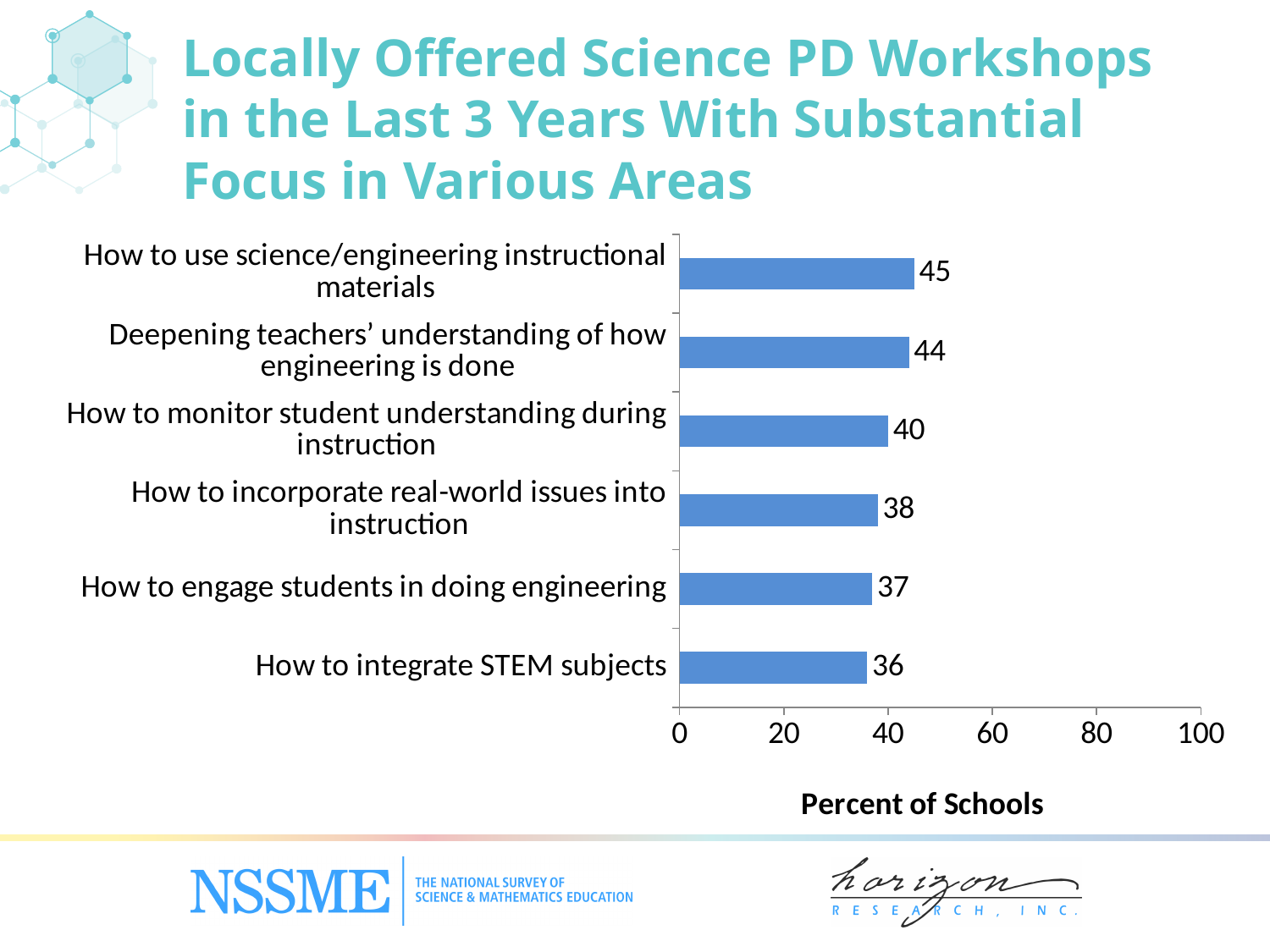
What kind of chart is shown on the slide? bar chart What is the value for 'How to monitor student understanding during instruction'? 40 Which category has the lowest percent of schools? How to integrate STEM subjects What is the value for 'How to integrate STEM subjects'? 36 Which is larger: the value for 'Deepening teachers' understanding of how engineering is done' or the value for 'How to incorporate real-world issues into instruction'? Deepening teachers' understanding of how engineering is done What percent of schools had locally offered science PD workshops with substantial focus on how to use science/engineering instructional materials? 45 What is the difference between the values for 'How to monitor student understanding during instruction' and 'How to engage students in doing engineering'? 3 What is the label of the horizontal axis? Percent of Schools Which category has the highest percent of schools? How to use science/engineering instructional materials Is the value for 'How to engage students in doing engineering' greater or less than 40? less What is the difference between the values for 'How to use science/engineering instructional materials' and 'How to integrate STEM subjects'? 9 How many categories are shown in the chart? 6